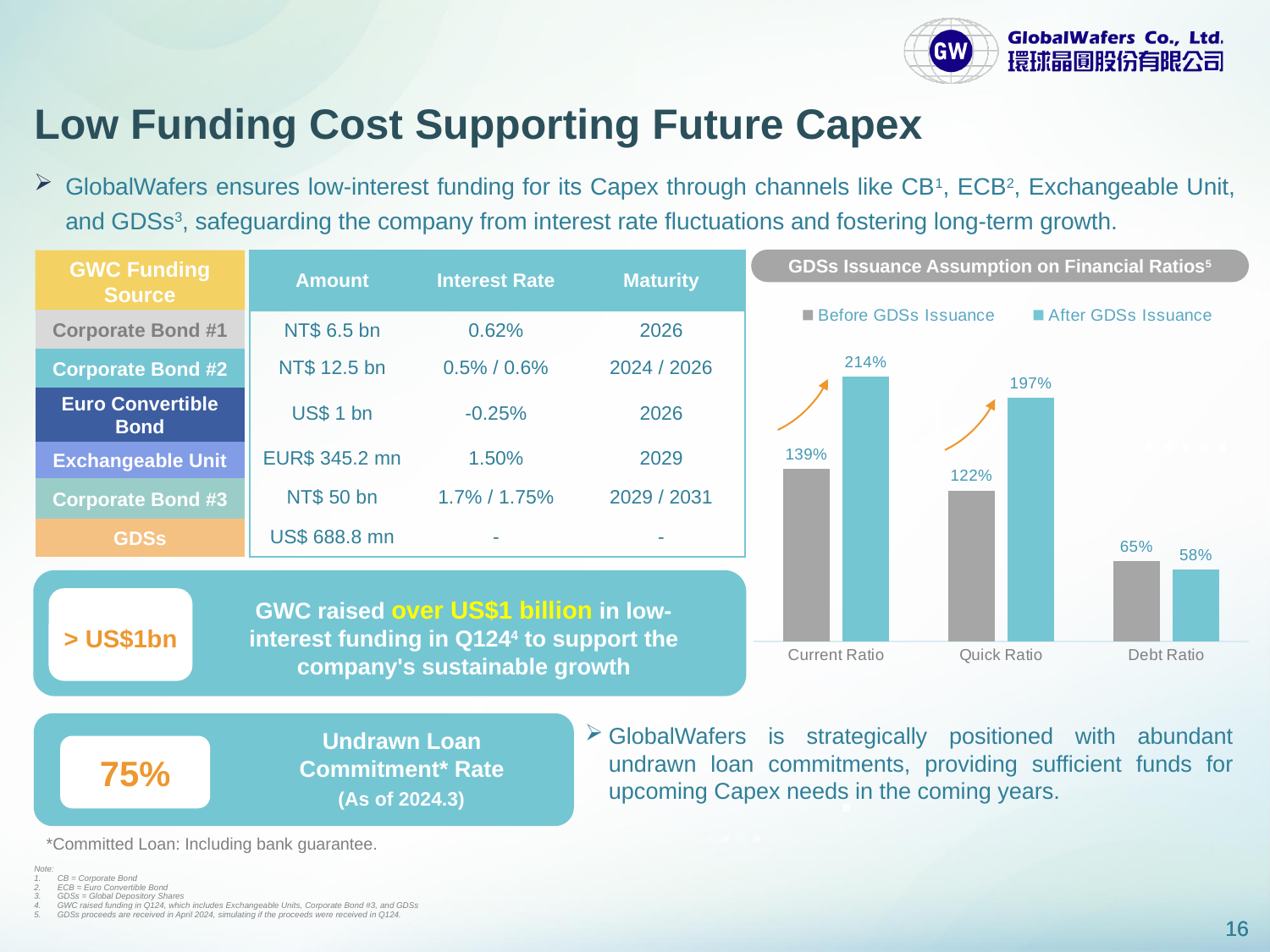
What is the Current Ratio before GDSs issuance? 139% How many categories are shown on the x axis of the chart? 3 What is the Quick Ratio after GDSs issuance? 197% Is the Debt Ratio higher before or after GDSs issuance? Before GDSs Issuance How many series does the chart legend list? 2 Which category has the highest value for the After GDSs Issuance series? Current Ratio What is the Debt Ratio before GDSs issuance? 65% What is the title of the chart? GDSs Issuance Assumption on Financial Ratios What kind of chart is shown on the slide? Bar chart What is the Current Ratio after GDSs issuance? 214% Which category has the lowest value for the Before GDSs Issuance series? Debt Ratio What is the difference between the Quick Ratio after and before GDSs issuance? 75%